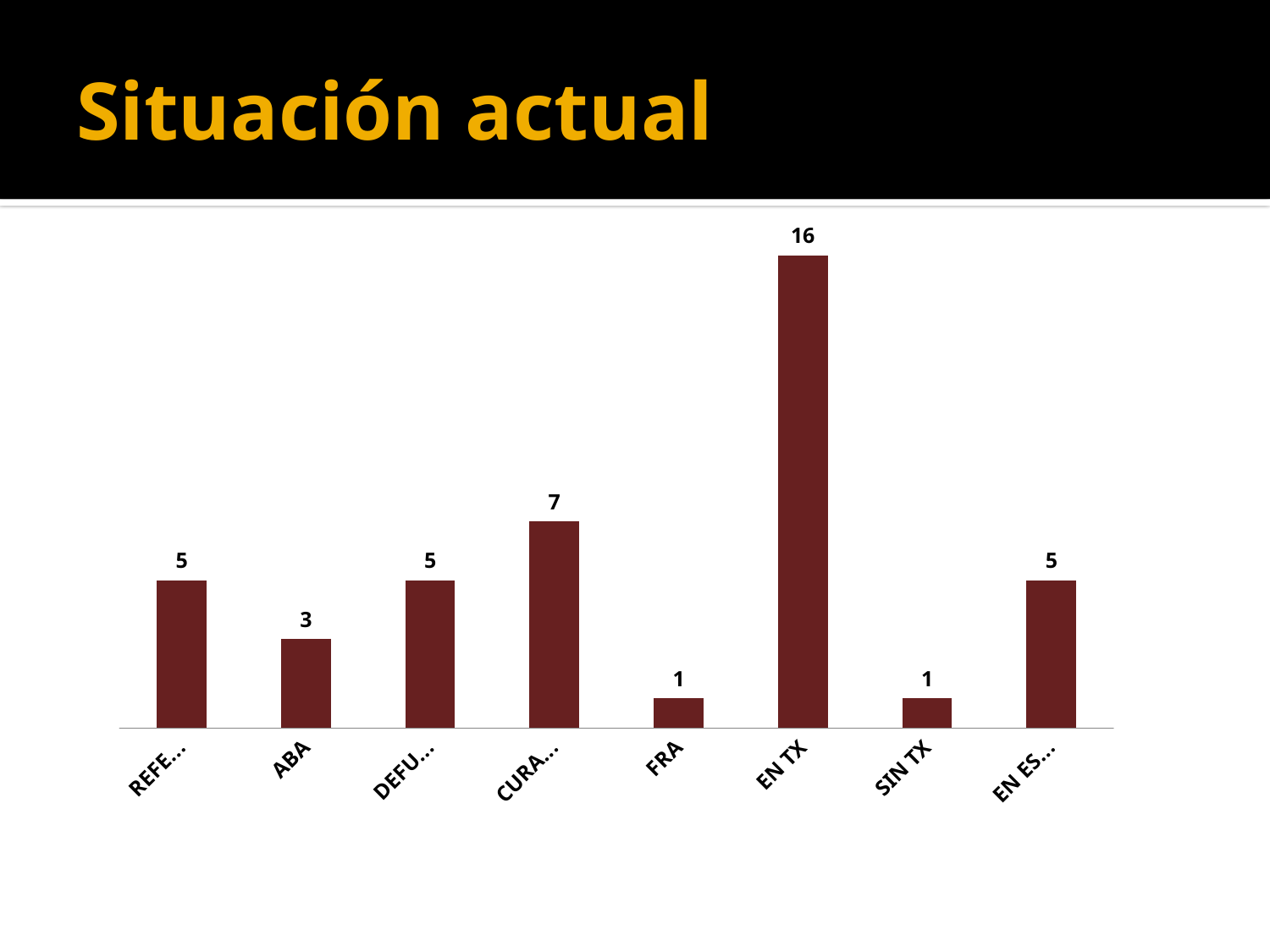
What is the difference between the EN TX value and the SIN TX value? 15 What is the value of the EN TX bar? 16 What is the difference between the EN TX value and the ABA value? 13 Which categories share the lowest value? FRA and SIN TX What kind of chart is shown on the slide? Bar chart What is the value of the FRA bar? 1 What is the title of the slide? Situación actual Which category has the highest value? EN TX How many bars are shown in the chart? 8 Which is larger, the value for ABA or the value for FRA? ABA What is the value of the ABA bar? 3 What is the value of the SIN TX bar? 1